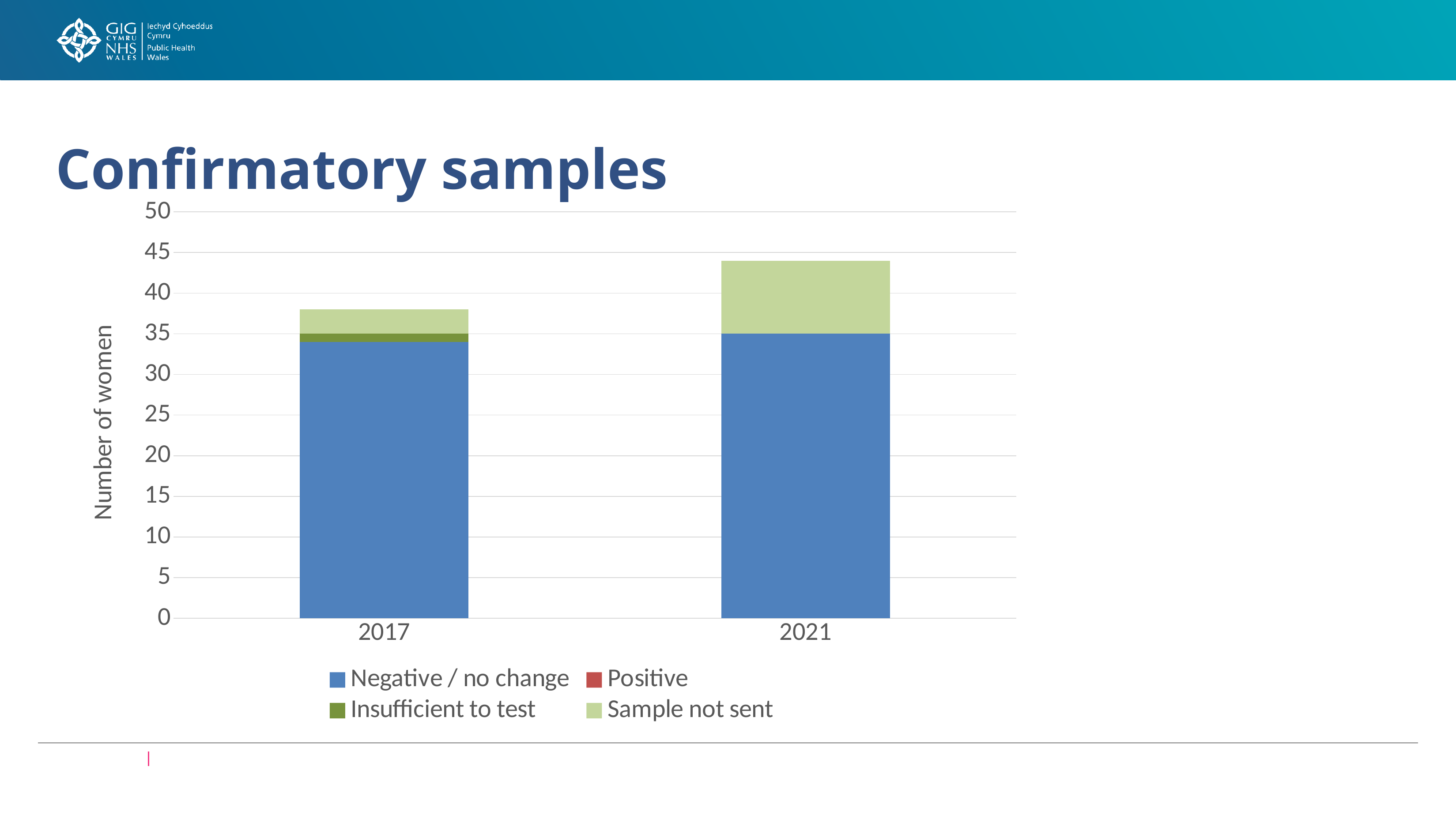
Is the 'Negative / no change' value for 2021 greater or less than 30? greater What is the title of the slide containing the chart? Confirmatory samples Is the total height of the 2017 bar greater or less than 40? less How many years (categories) are shown on the x axis? 2 Does the total number of women rise or fall from 2017 to 2021? rise Which year has the taller total stacked bar, 2017 or 2021? 2021 Is the 'Negative / no change' value for 2017 greater or less than 30? greater What is the label on the y axis? Number of women How many series does the legend list? 4 What kind of chart is shown on the slide? bar chart